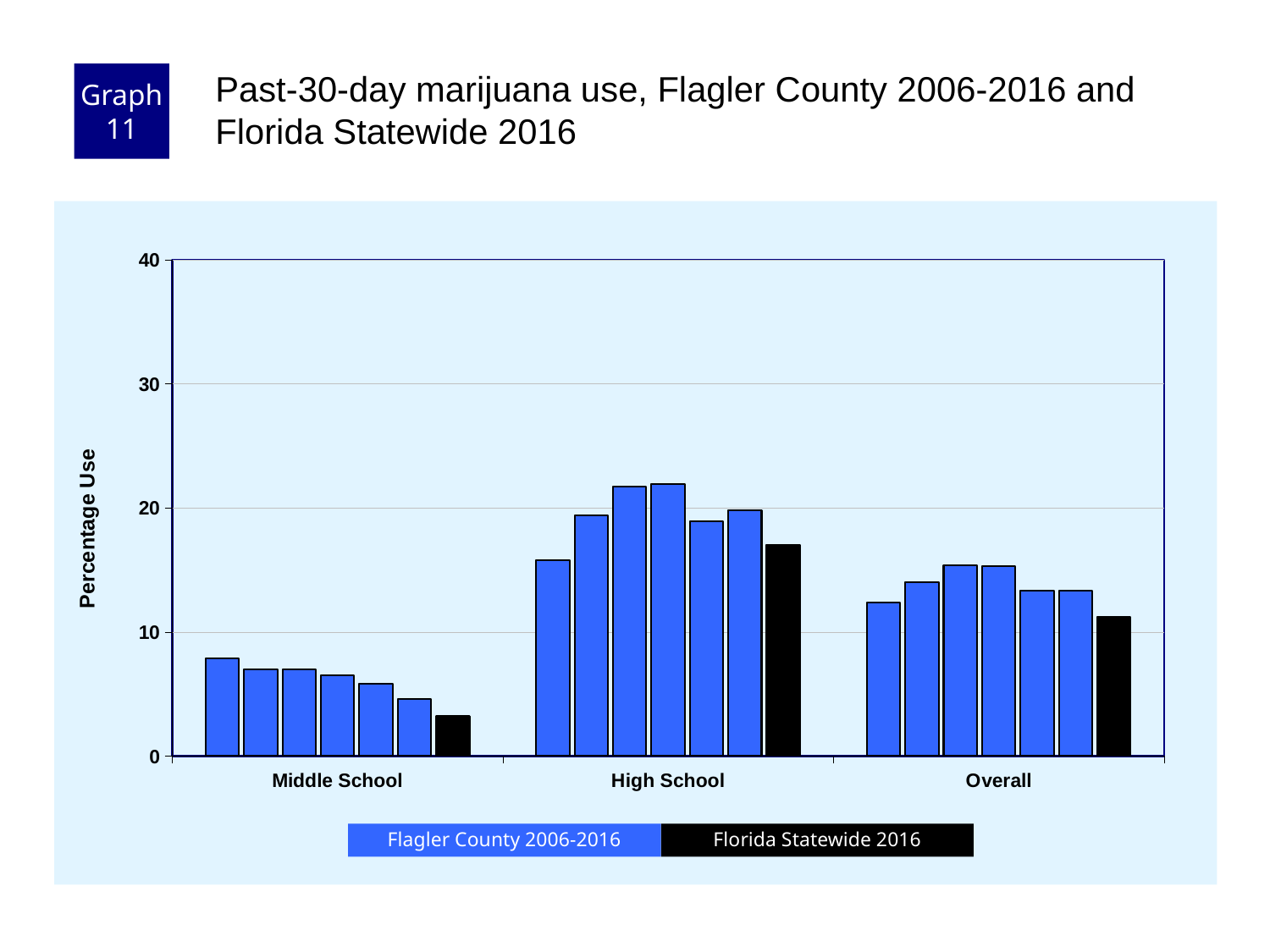
What are the two series named in the legend? Flagler County 2006-2016 and Florida Statewide 2016 Which category has the lowest bars overall? Middle School What kind of chart is shown on the slide? Bar chart Which is larger: the Florida Statewide 2016 value for High School or for Middle School? High School Do the Flagler County bars for Middle School rise or fall from left to right? fall How many series does the legend list? 2 Is the Florida Statewide 2016 value for High School greater or less than 10? greater What is the label on the y axis? Percentage Use Is the Florida Statewide 2016 value for Middle School greater or less than 10? less Is the Florida Statewide 2016 value for High School greater or less than 20? less How many categories are shown on the x axis? 3 Which category has the highest bars overall? High School